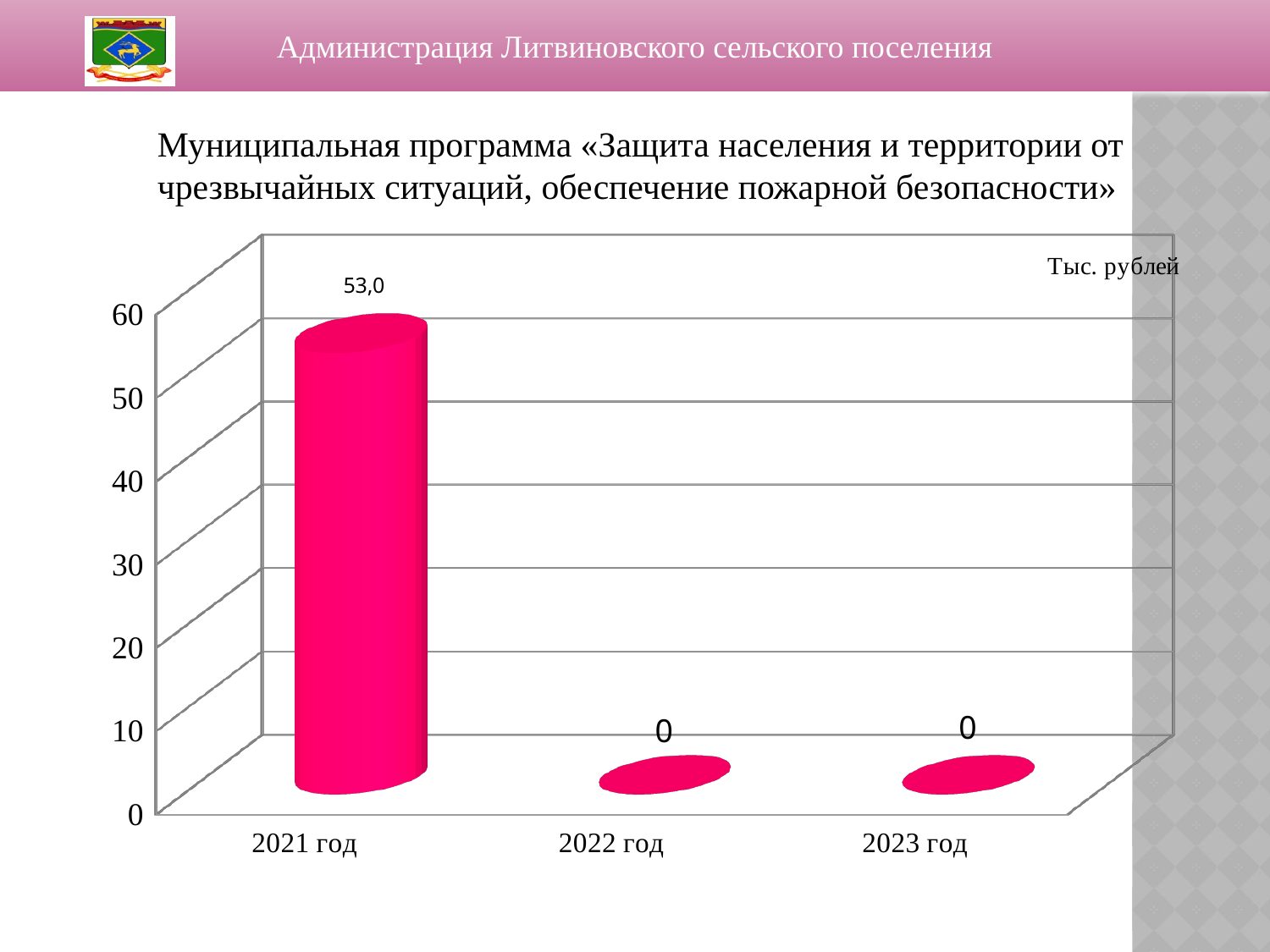
What kind of chart is shown on the slide? bar chart How many years are shown on the x axis? 3 Is the value for 2021 год greater or less than 50? greater What unit is indicated in the top right corner of the chart? Тыс. рублей What is the highest tick value shown on the vertical axis? 60 What is the value for 2023 год? 0 Do the values rise or fall from 2021 год to 2023 год? fall Which year has the highest value? 2021 год What is the difference between the values for 2021 год and 2022 год? 53,0 What is the value for 2021 год? 53,0 Which is larger, the value for 2021 год or the value for 2023 год? 2021 год What is the value for 2022 год? 0